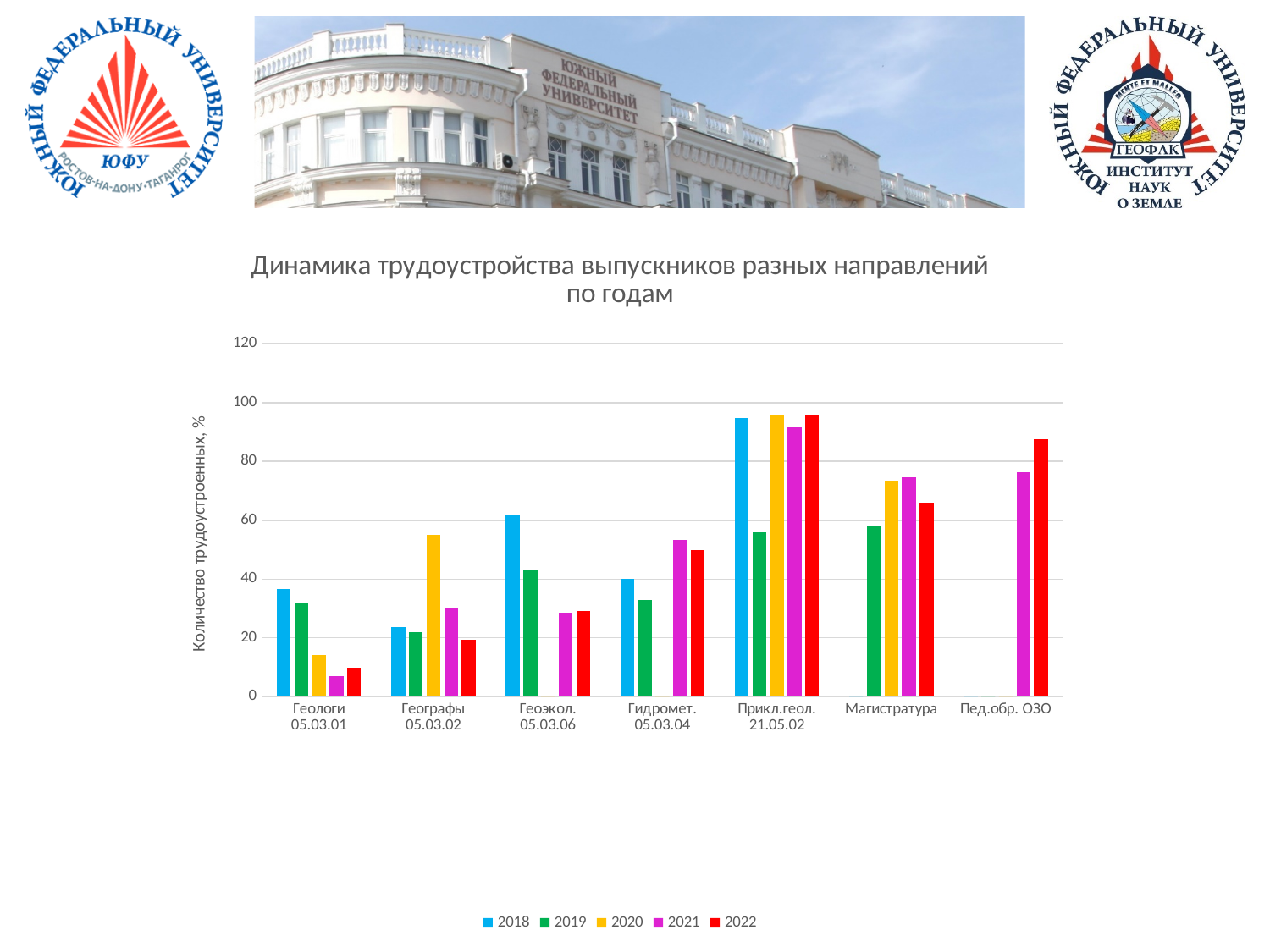
Is the value for Географы 05.03.02 in 2020 greater or less than 40? greater Is the value for Пед.обр. ОЗО in 2022 greater or less than 80? greater Which category has the lowest value for 2022? Геологи 05.03.01 Which category has the highest value for 2018? Прикл.геол. 21.05.02 Is the value for Геологи 05.03.01 in 2021 greater or less than 20? less What is the title of the vertical axis? Количество трудоустроенных, % How many series does the legend list? 5 What kind of chart is shown on the slide? bar chart For Гидромет. 05.03.04, which year has the larger value: 2019 or 2021? 2021 For Магистратура, which year has the larger value: 2019 or 2022? 2022 How many categories are shown on the x axis? 7